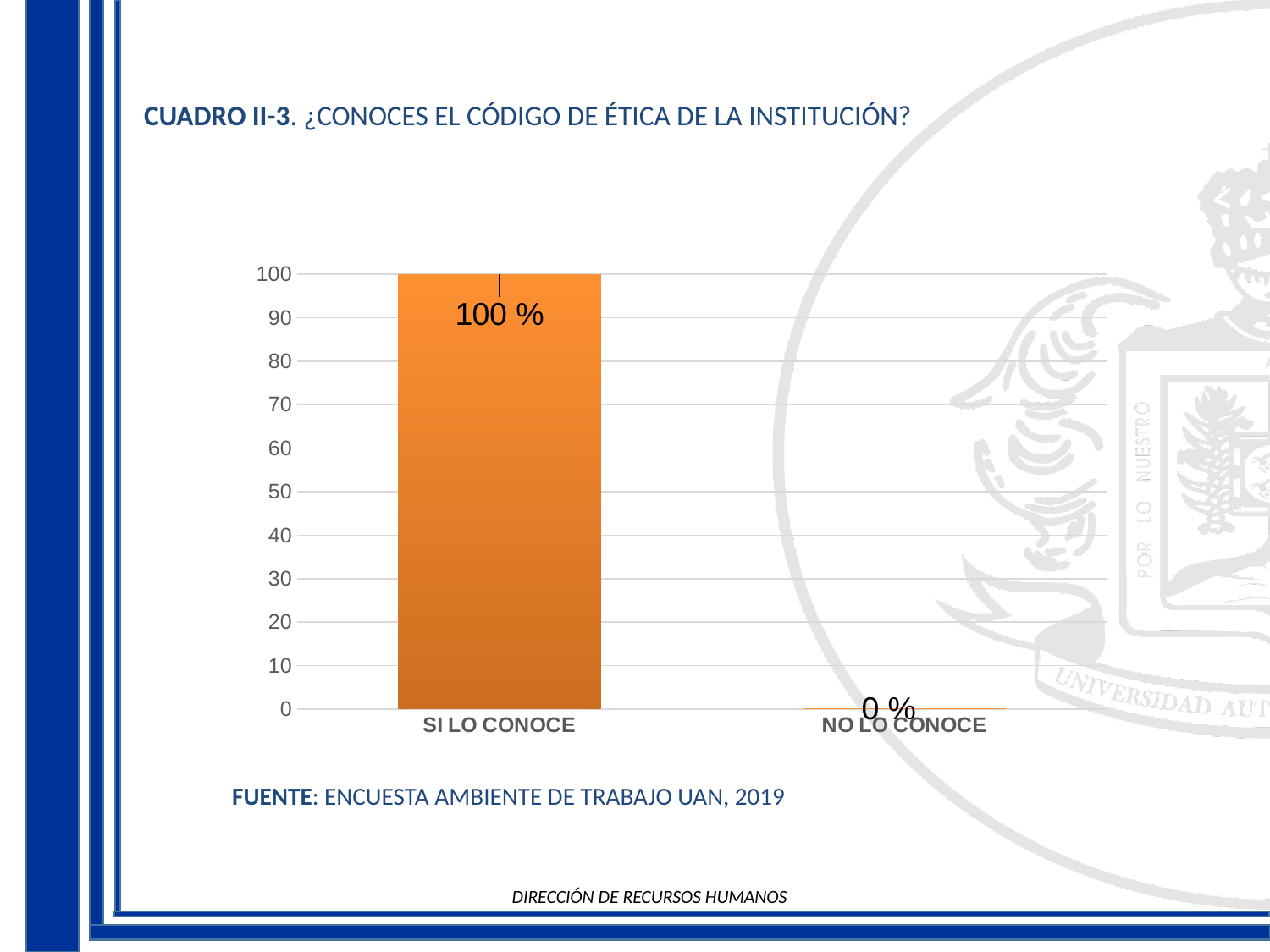
How many categories are shown in the chart? 2 Is the value for SI LO CONOCE greater or less than 50? greater What is the maximum value shown on the vertical axis? 100 Which is larger, the value for SI LO CONOCE or NO LO CONOCE? SI LO CONOCE What kind of chart is shown on the slide? bar chart What source is cited below the chart? ENCUESTA AMBIENTE DE TRABAJO UAN, 2019 Which category has the highest value? SI LO CONOCE What is the value for NO LO CONOCE? 0 % What is the value for SI LO CONOCE? 100 % What is the title of the chart? CUADRO II-3. ¿CONOCES EL CÓDIGO DE ÉTICA DE LA INSTITUCIÓN? Which category has the lowest value? NO LO CONOCE What is the difference between the values for SI LO CONOCE and NO LO CONOCE? 100 %